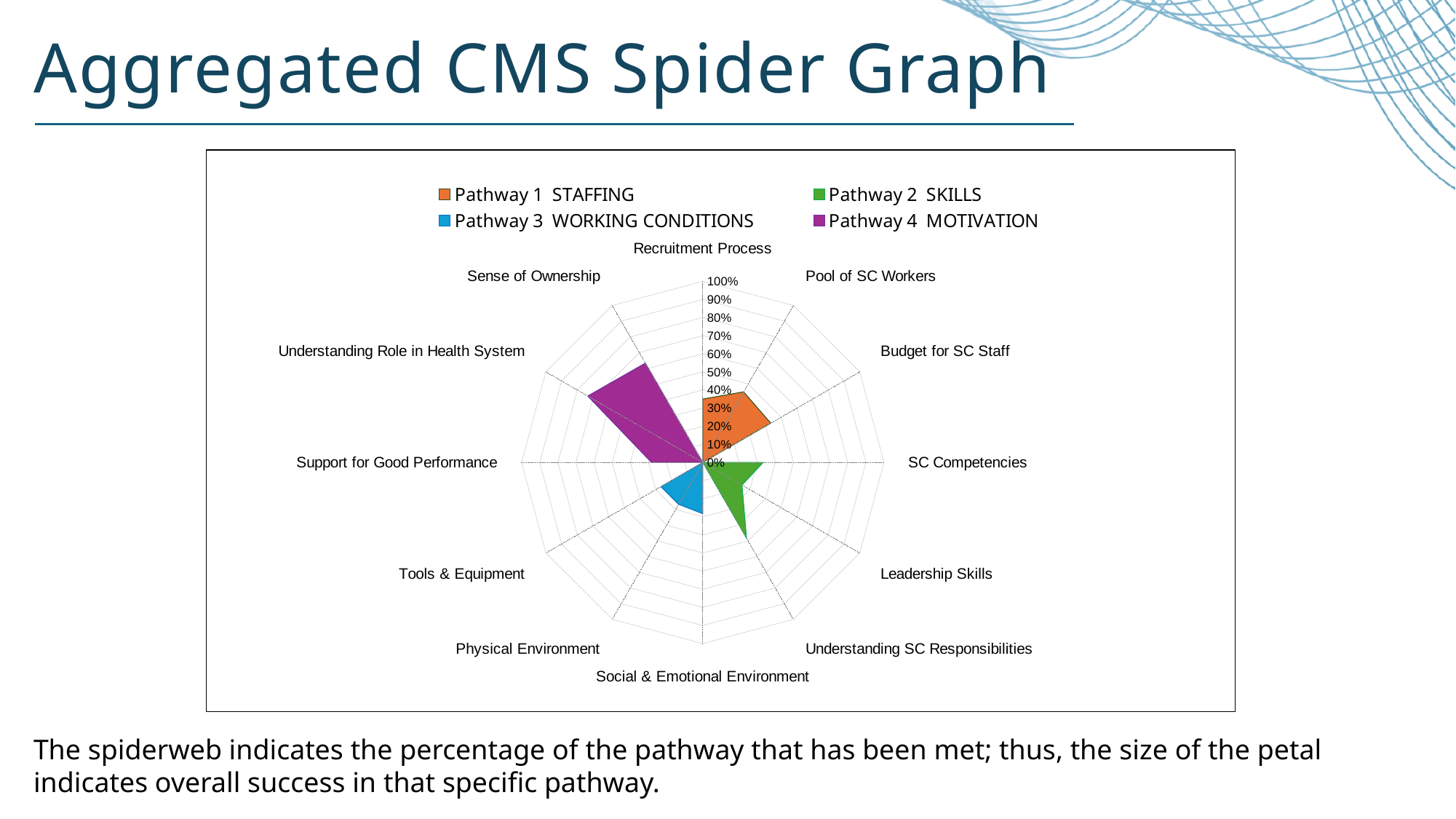
Which category has the highest value on the spider graph? Understanding Role in Health System Is the value for Understanding Role in Health System greater or less than 50%? greater Which is larger, the value for Understanding Role in Health System or the value for Recruitment Process? Understanding Role in Health System Is the value for Sense of Ownership greater or less than 40%? greater Is the value for Leadership Skills greater or less than 40%? less Which pathway is shown in purple in the legend? Pathway 4 MOTIVATION How many categories (axes) does the spider graph have? 12 Which pathway has the largest petal on the spider graph? Pathway 4 MOTIVATION What is the maximum value shown on the radial axis? 100% What kind of chart is shown on the slide? Radar (spider) chart How many series does the legend list? 4